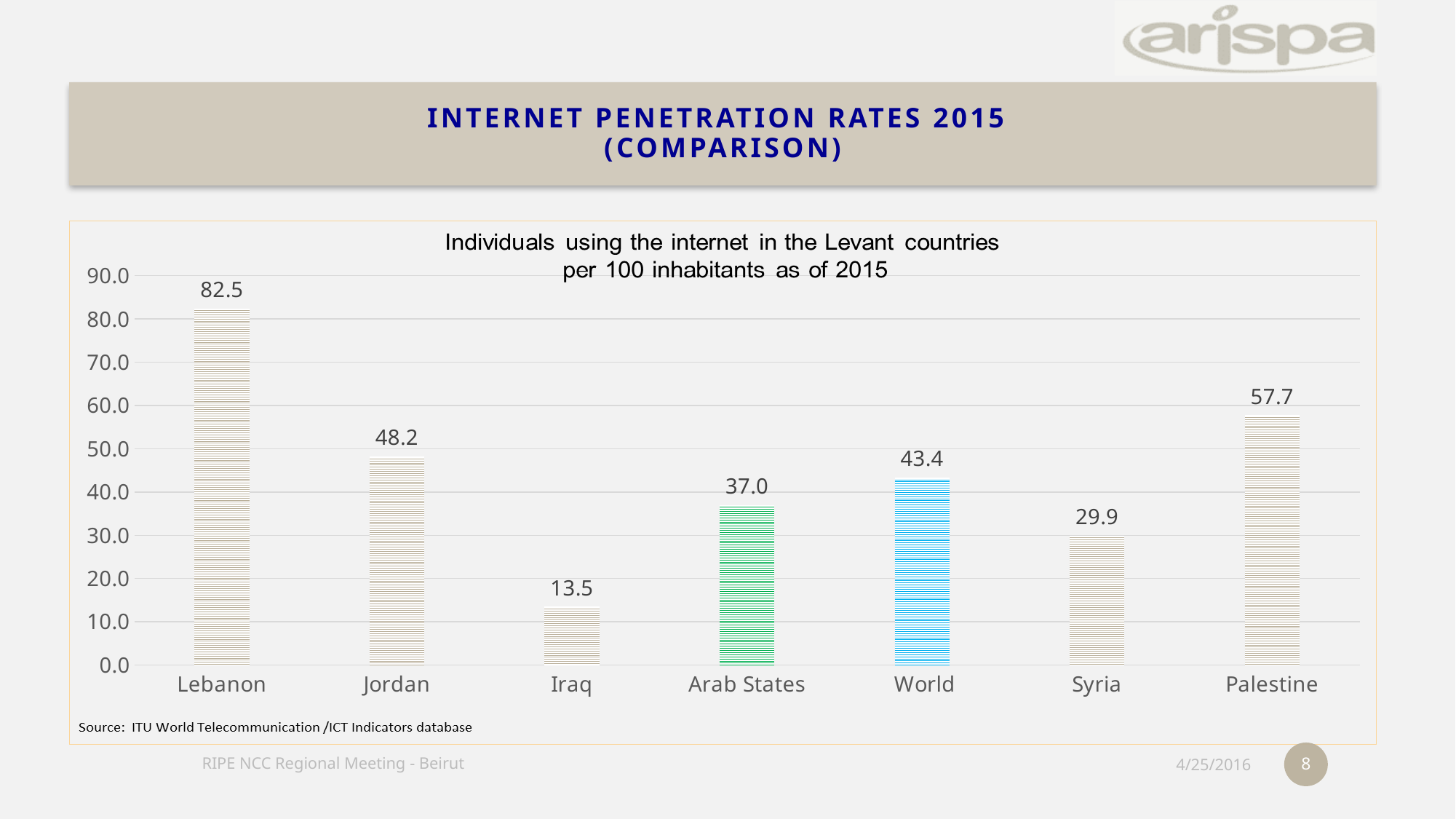
What kind of chart is shown? bar chart What is the source cited below the chart? ITU World Telecommunication /ICT Indicators database How many categories are shown on the x axis? 7 Which category has the lowest value? Iraq What is the difference between the values for Palestine and Jordan? 9.5 Which category has the highest value? Lebanon What is the value for Lebanon? 82.5 Which is larger, the value for Arab States or the value for Syria? Arab States Is the value for Syria greater or less than 30.0? less What is the title of the chart? Individuals using the internet in the Levant countries per 100 inhabitants as of 2015 What is the value for World? 43.4 What is the value for Iraq? 13.5